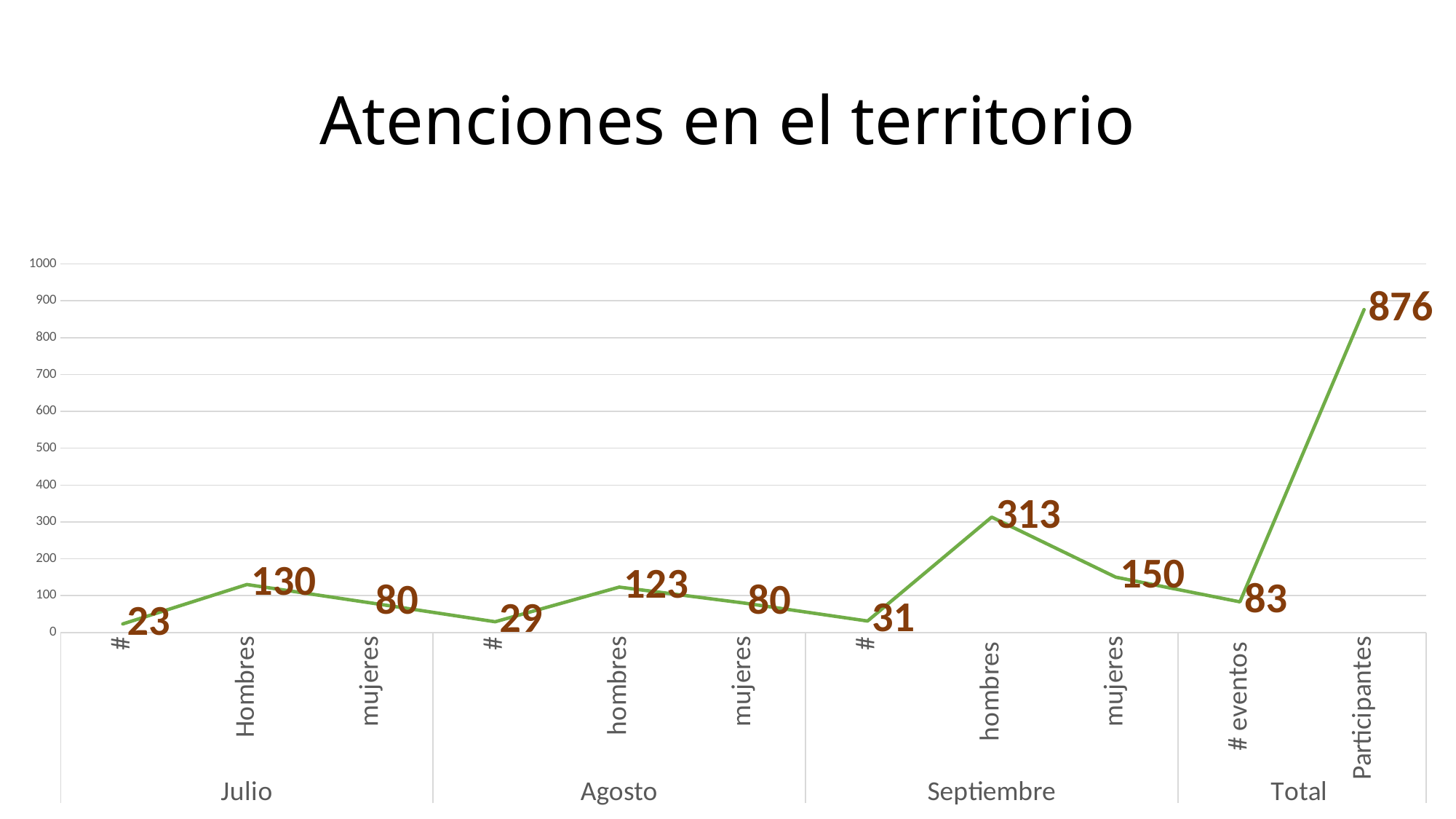
Which is larger, Hombres in Julio or hombres in Agosto? Hombres in Julio How many data points are plotted on the line? 11 What is the difference between hombres and mujeres in Septiembre? 163 What is the value for hombres in Septiembre? 313 What type of chart is shown on the slide? line chart What is the value for Participantes under Total? 876 How many month groups (including Total) are shown on the x axis? 4 Which point on the line has the lowest value? # in Julio Which point on the line has the highest value? Participantes What is the title of the chart? Atenciones en el territorio What is the value for # eventos under Total? 83 What is the value for Hombres in Julio? 130